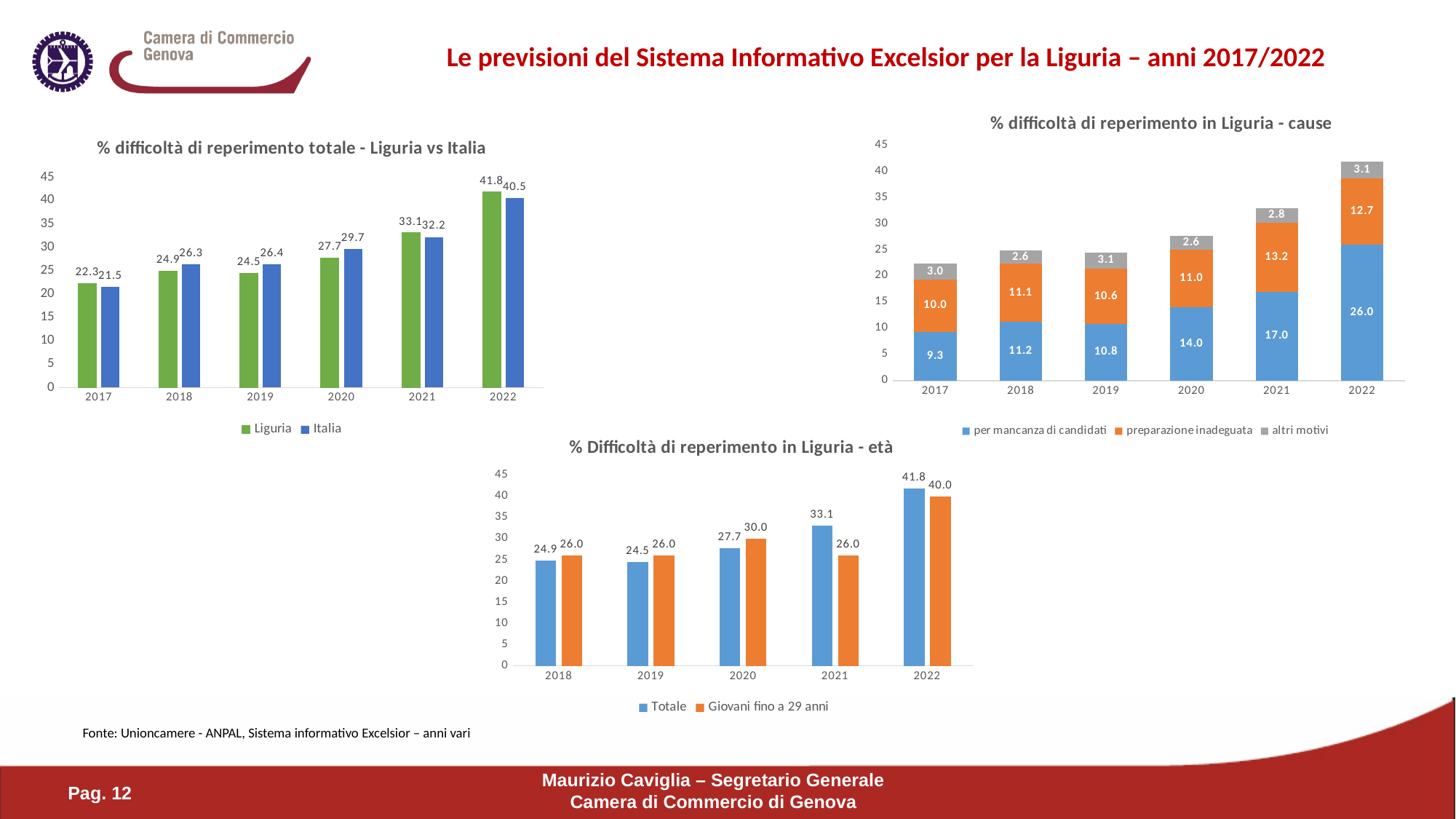
In the chart '% difficoltà di reperimento totale - Liguria vs Italia', what is the difference between Liguria and Italia in 2022? 1.3 In the chart '% difficoltà di reperimento totale - Liguria vs Italia', how many series does the legend list? 2 In the chart '% Difficoltà di reperimento in Liguria - età', what is the difference between Totale and Giovani fino a 29 anni in 2021? 7.1 What kind of chart is '% Difficoltà di reperimento in Liguria - età'? Bar chart In the chart '% difficoltà di reperimento totale - Liguria vs Italia', which is larger in 2019, Liguria or Italia? Italia In the chart '% difficoltà di reperimento totale - Liguria vs Italia', which year has the highest value for Liguria? 2022 In the chart '% difficoltà di reperimento in Liguria - cause', which year has the lowest value for 'per mancanza di candidati'? 2017 In the chart '% difficoltà di reperimento totale - Liguria vs Italia', what is the value for Italia in 2020? 29.7 In the chart '% Difficoltà di reperimento in Liguria - età', what is the value for 'Giovani fino a 29 anni' in 2020? 30.0 In the chart '% difficoltà di reperimento in Liguria - cause', what is the total of the stacked bar for 2022? 41.8 In the chart '% difficoltà di reperimento in Liguria - cause', what is the value for 'per mancanza di candidati' in 2021? 17.0 In the chart '% difficoltà di reperimento in Liguria - cause', how many years are shown on the x axis? 6